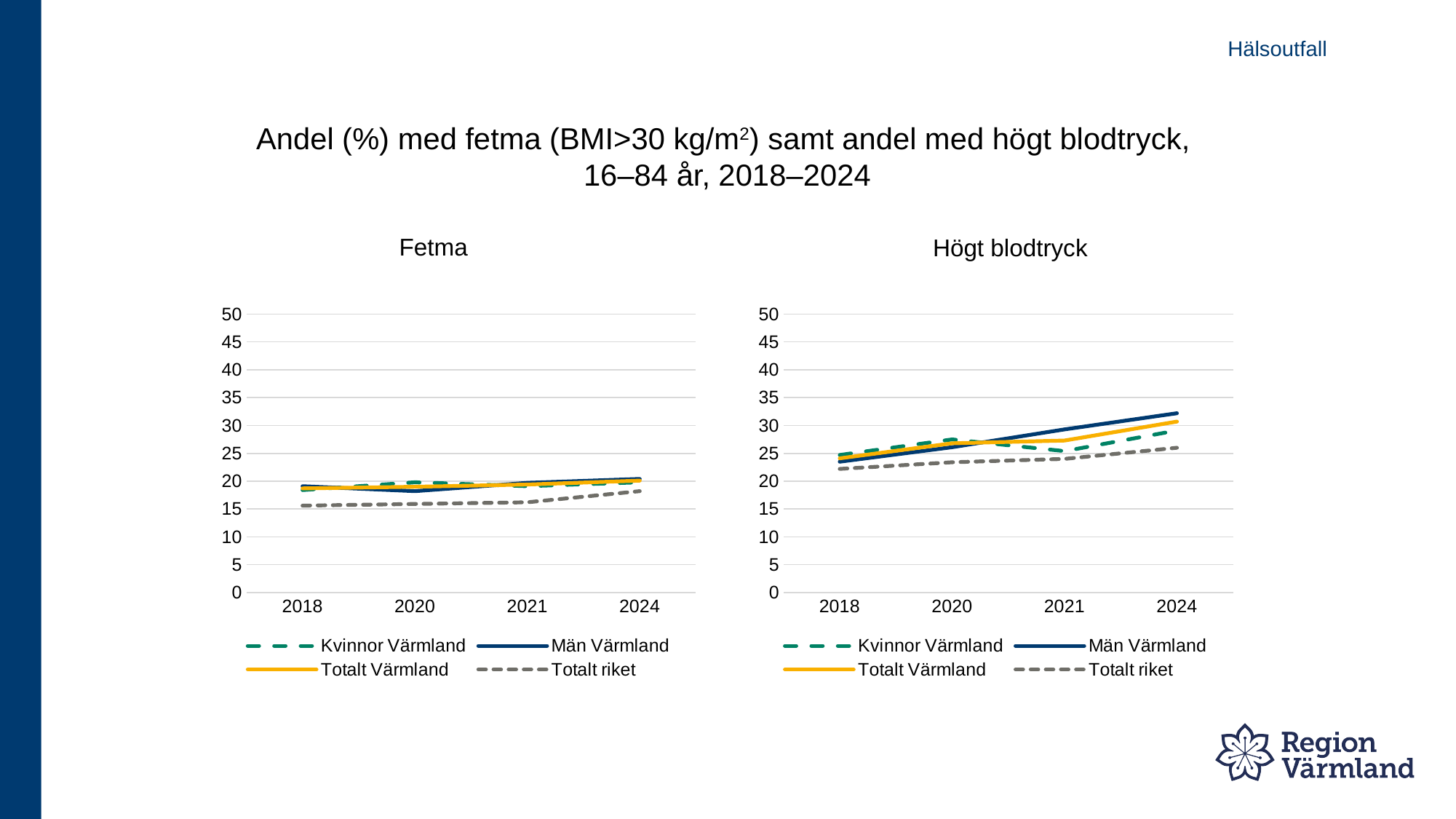
In the Fetma chart, is the value for Totalt riket in 2018 greater or less than 20? less How many series does the legend of the Högt blodtryck chart list? 4 In the Högt blodtryck chart, which series has the highest value in 2024? Män Värmland How many years are shown on the x axis of the Fetma chart? 4 In the Högt blodtryck chart, does the Män Värmland line rise or fall from 2018 to 2024? rise In the Fetma chart, does the Totalt riket line rise or fall from 2018 to 2024? rise In the Högt blodtryck chart, is the value for Totalt riket in 2018 greater or less than 25? less In the Högt blodtryck chart, which is larger in 2024: Män Värmland or Totalt riket? Män Värmland What kind of chart is the Fetma chart? line chart What is the title of the chart on the right side of the slide? Högt blodtryck In the Högt blodtryck chart, is the value for Män Värmland in 2024 greater or less than 30? greater In the Fetma chart, which series has the lowest value in 2020? Totalt riket